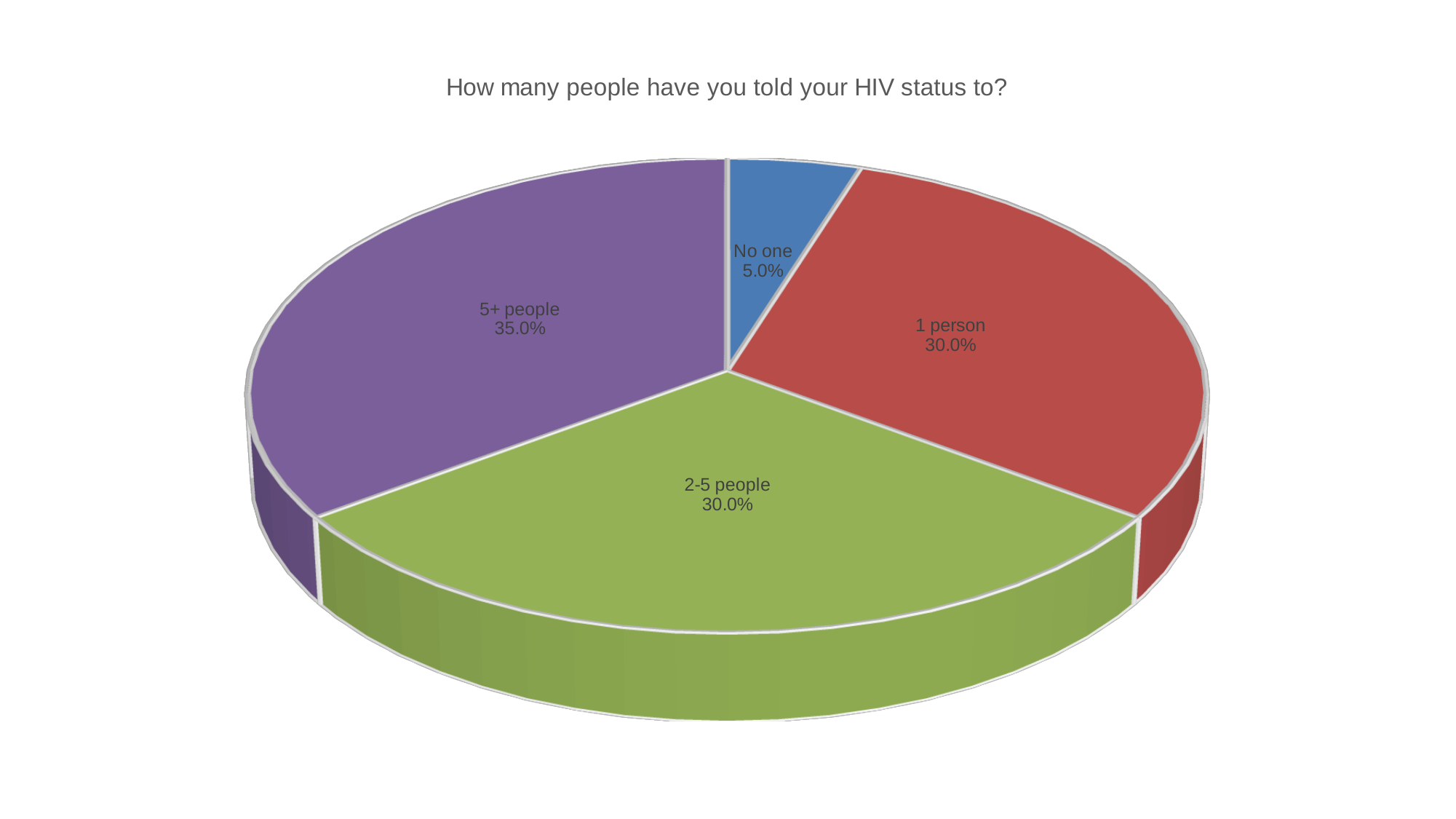
How many slices does the pie chart have? 4 What share of the pie is labelled "5+ people"? 35.0% What kind of chart is shown on the slide? Pie chart Which is larger, the "5+ people" slice or the "1 person" slice? 5+ people What share of the pie is labelled "No one"? 5.0% What share of the pie is labelled "2-5 people"? 30.0% Which category has the largest slice of the pie? 5+ people Which category has the smallest slice of the pie? No one What is the difference in percentage points between the "5+ people" slice and the "No one" slice? 30.0% What colour is the "2-5 people" slice? Green What is the title of the chart? How many people have you told your HIV status to?